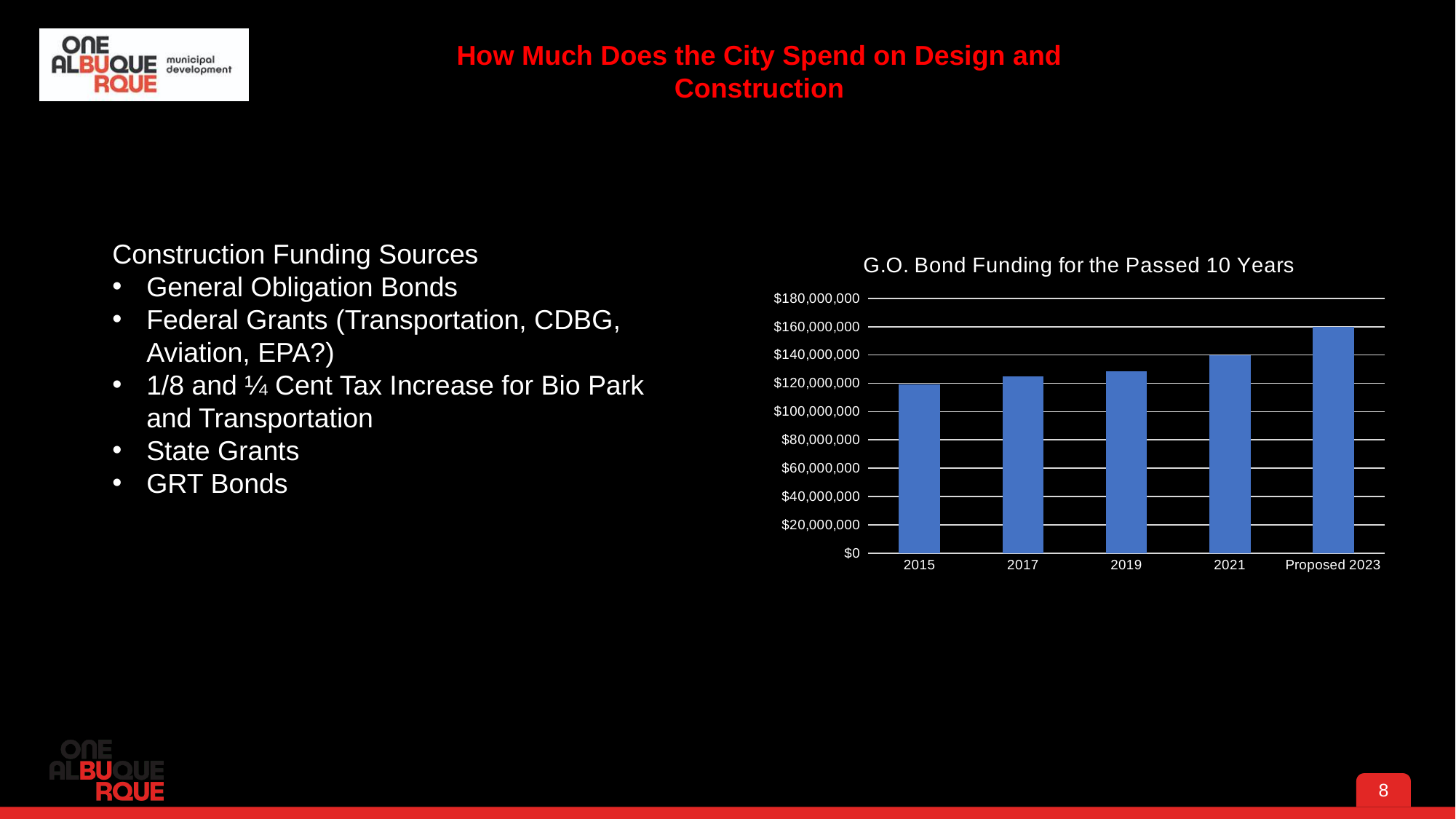
Is the value for 2017 greater or less than $120,000,000? greater Which category has the highest G.O. bond funding? Proposed 2023 Which year has the lowest G.O. bond funding? 2015 Is the value for 2015 greater or less than $100,000,000? greater What type of chart is shown on the slide? Bar chart How many categories are shown on the x axis of the chart? 5 Do the G.O. bond funding values rise or fall from 2015 to Proposed 2023? Rise What is the title of the chart? G.O. Bond Funding for the Passed 10 Years Is the value for 2019 greater or less than $140,000,000? less Which has the larger G.O. bond funding, 2015 or 2021? 2021 What is the highest value shown on the y axis of the chart? $180,000,000